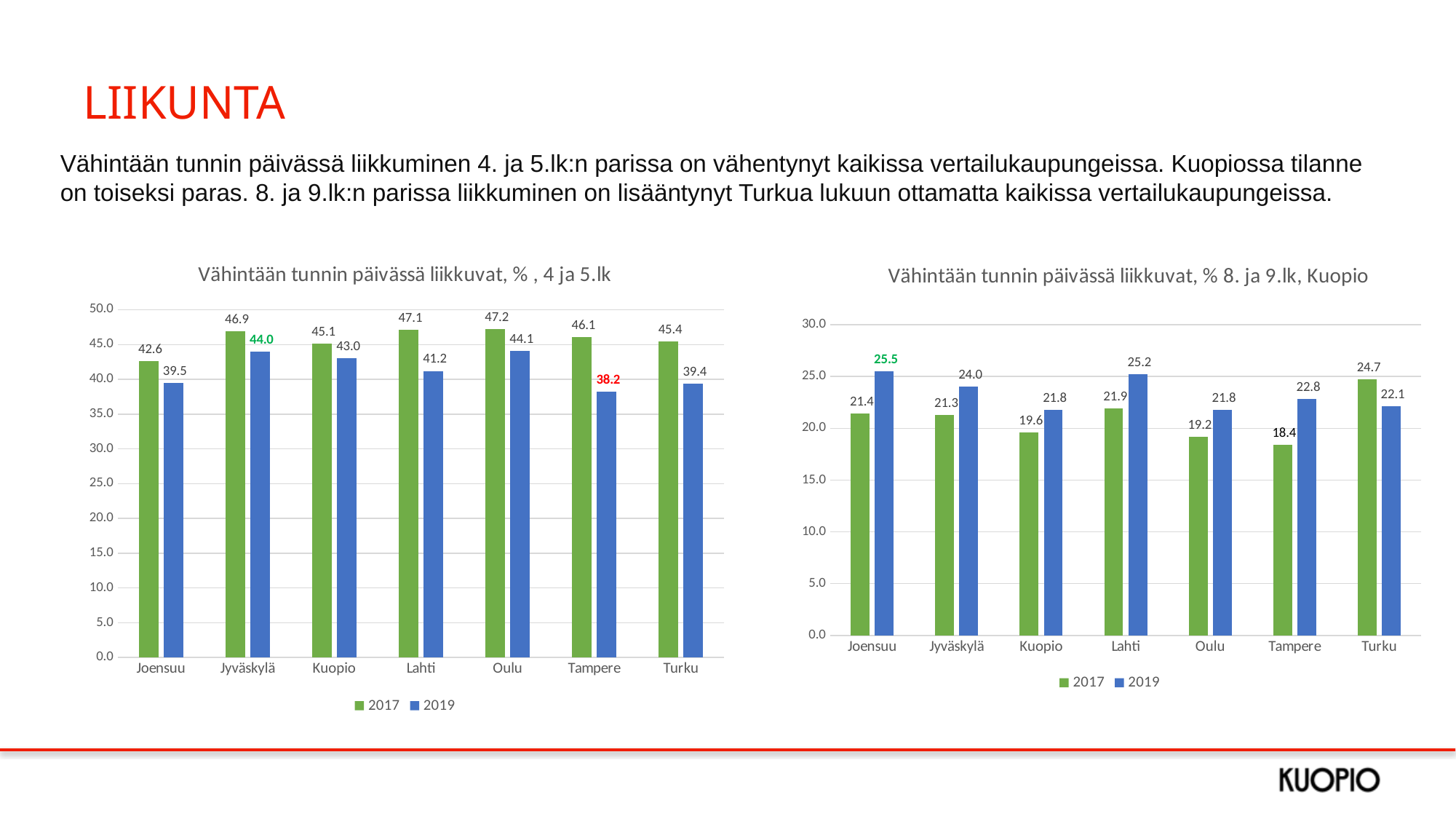
In the left chart (4 ja 5.lk), what is the 2017 value for Oulu? 47.2 What type of chart is the left chart (4 ja 5.lk)? Bar chart In the right chart (8. ja 9.lk), what is the 2019 value for Joensuu? 25.5 In the left chart (4 ja 5.lk), which city has the lowest 2019 value? Tampere In the right chart (8. ja 9.lk), what is the difference between the 2019 and 2017 values for Tampere? 4.4 In the left chart (4 ja 5.lk), what is the difference between the 2017 and 2019 values for Lahti? 5.9 In the right chart (8. ja 9.lk), is the 2017 value for Turku larger or the 2019 value for Turku? 2017 In the left chart (4 ja 5.lk), what is the 2019 value for Kuopio? 43.0 In the right chart (8. ja 9.lk), which city has the lowest 2017 value? Tampere How many series does the legend of the right chart (8. ja 9.lk) list? 2 In the left chart (4 ja 5.lk), which city has the highest 2019 value? Oulu In the left chart (4 ja 5.lk), how many cities are shown on the x axis? 7